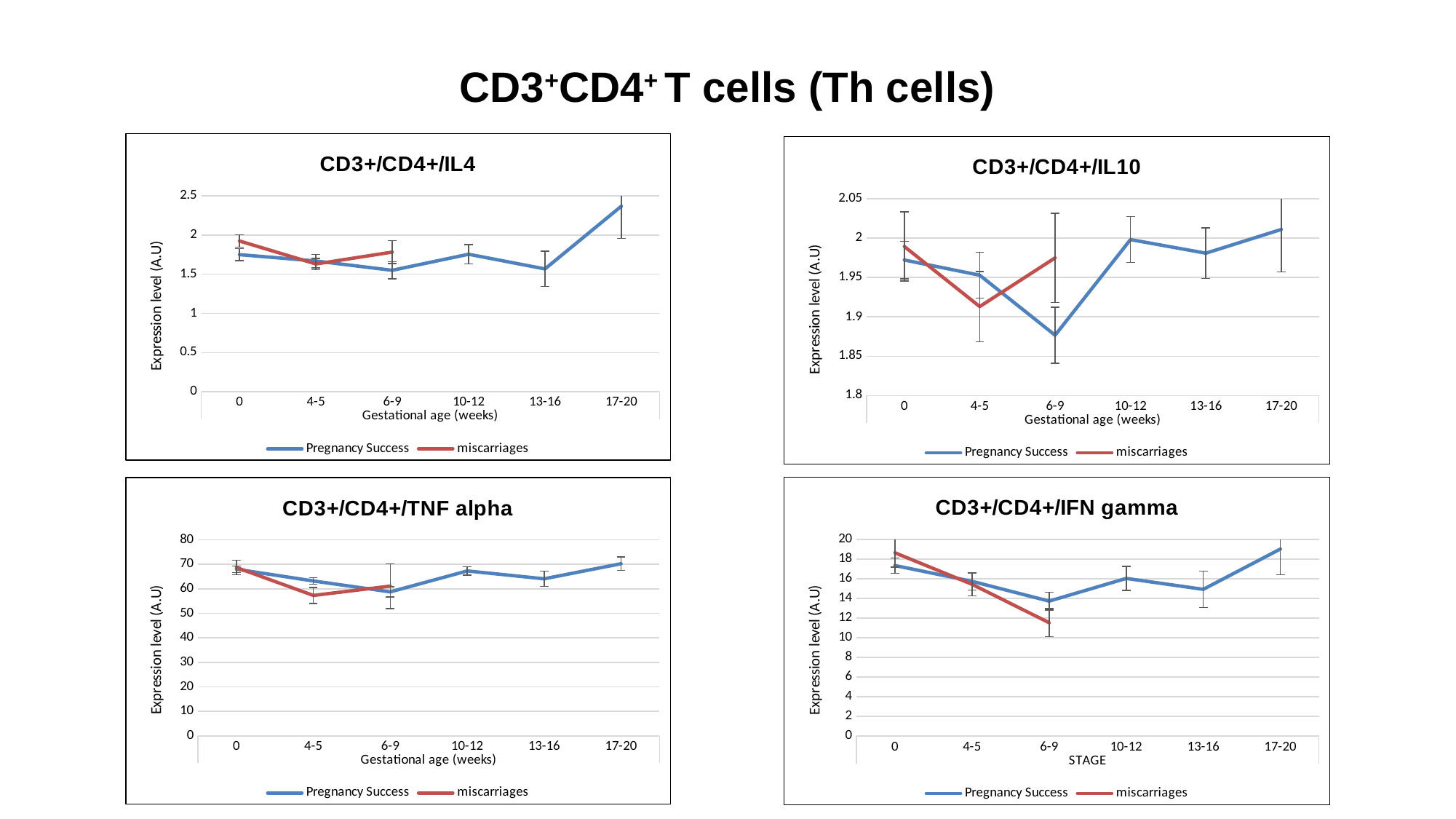
How many gestational age categories are shown on the x axis of the CD3+/CD4+/TNF alpha chart? 6 In the CD3+/CD4+/IL10 chart, is the Pregnancy Success value at 6-9 weeks greater or less than 1.9? less In the CD3+/CD4+/IFN gamma chart, at which stage is the Pregnancy Success value highest? 17-20 In the CD3+/CD4+/IL4 chart, is the Pregnancy Success value at 17-20 weeks greater or less than 2? greater In the CD3+/CD4+/IL4 chart, at which gestational age is the Pregnancy Success value highest? 17-20 In the CD3+/CD4+/IFN gamma chart, do the miscarriages values rise or fall from stage 0 to stage 6-9? fall In the CD3+/CD4+/IFN gamma chart, which series has the larger value at stage 0, Pregnancy Success or miscarriages? miscarriages In the CD3+/CD4+/TNF alpha chart, is the miscarriages value at 4-5 weeks greater or less than 60? less What kind of chart is the CD3+/CD4+/IL4 chart? line chart In the CD3+/CD4+/IL10 chart, at which gestational age is the Pregnancy Success value lowest? 6-9 What is the x-axis label of the CD3+/CD4+/IFN gamma chart? STAGE How many series does the legend of the CD3+/CD4+/IL10 chart list? 2